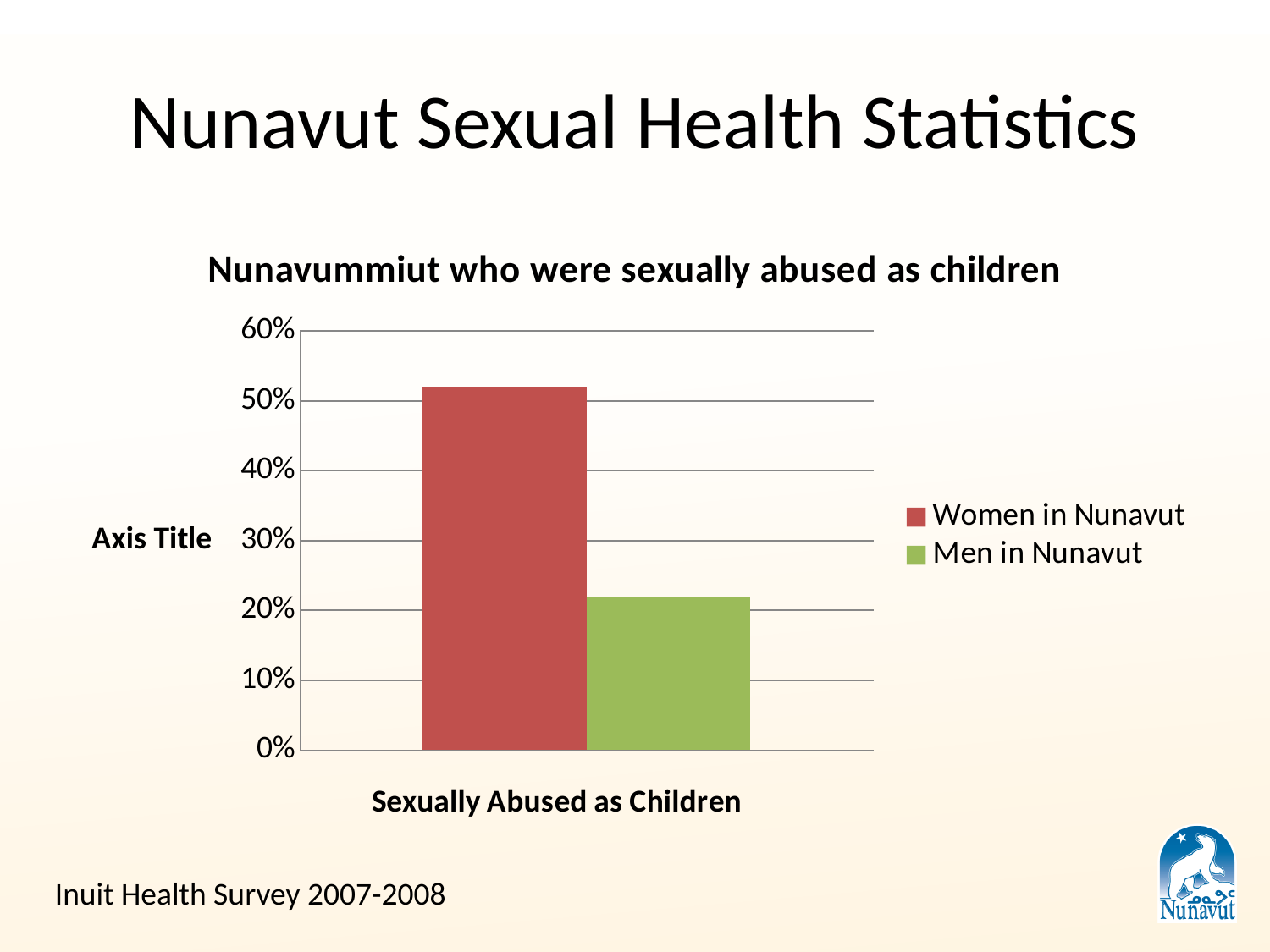
How many series does the chart legend list? 2 Is the value for Men in Nunavut greater or less than 20%? greater Is the value for Men in Nunavut greater or less than 30%? less Which series has the highest bar in the chart? Women in Nunavut How many categories are shown on the x axis of the chart? 1 Which series has the higher value for Sexually Abused as Children, Women in Nunavut or Men in Nunavut? Women in Nunavut What colour is the bar for Men in Nunavut? green What kind of chart is shown on the slide? bar chart Is the value for Women in Nunavut greater or less than 60%? less Which series has the lowest bar in the chart? Men in Nunavut What is the title of the chart? Nunavummiut who were sexually abused as children